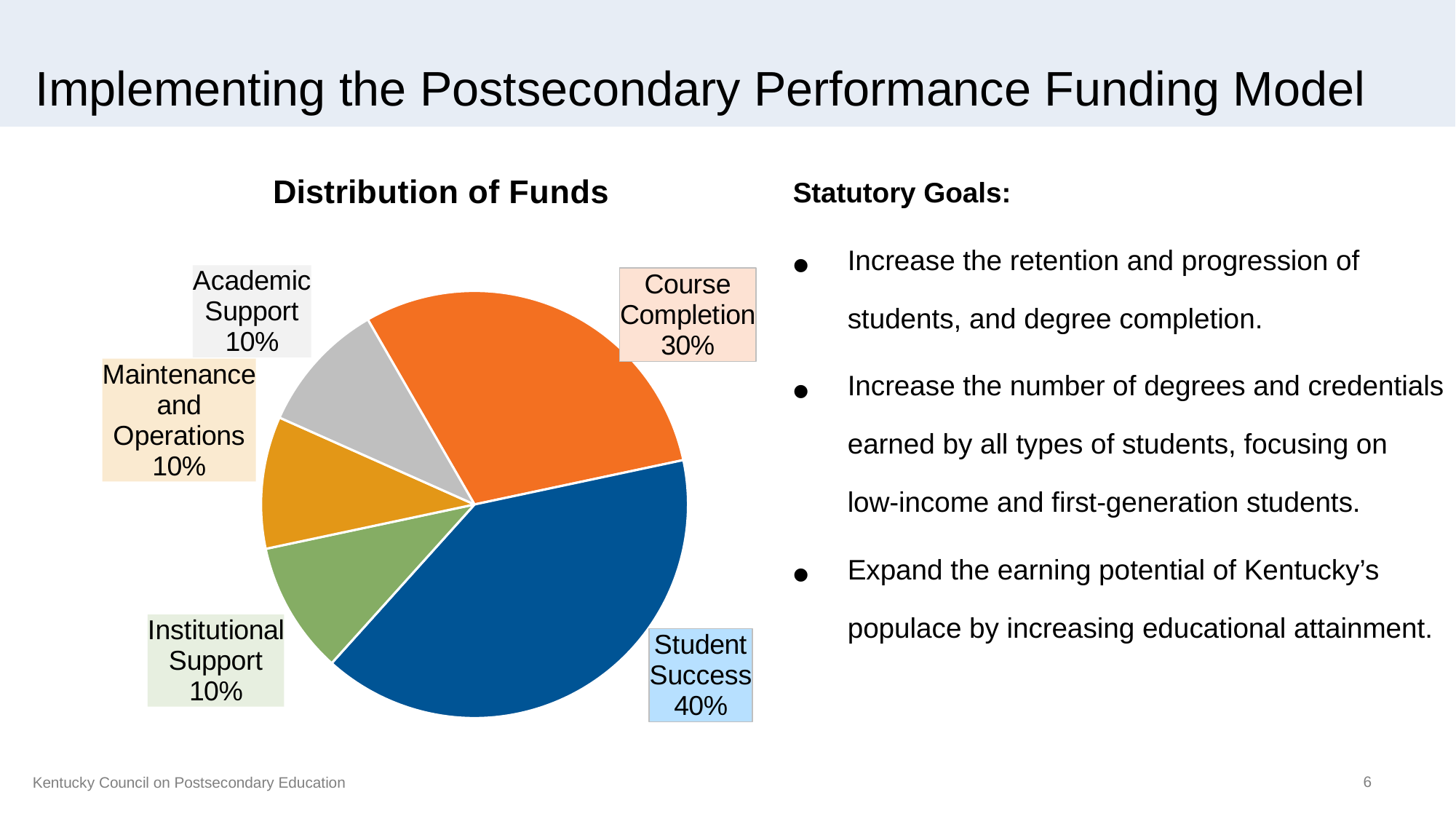
What is the combined share of Student Success and Course Completion? 70% What share of funds goes to Maintenance and Operations? 10% What colour is the Student Success slice? Blue How many categories are shown in the pie chart? 5 What is the title of the chart? Distribution of Funds What share of funds goes to Student Success? 40% What share of funds goes to Academic Support? 10% What kind of chart is shown on the slide? Pie chart Which category receives the largest share of funds? Student Success What share of funds goes to Course Completion? 30% What is the difference between the Student Success share and the Course Completion share? 10% Which is larger, the share for Course Completion or the share for Institutional Support? Course Completion